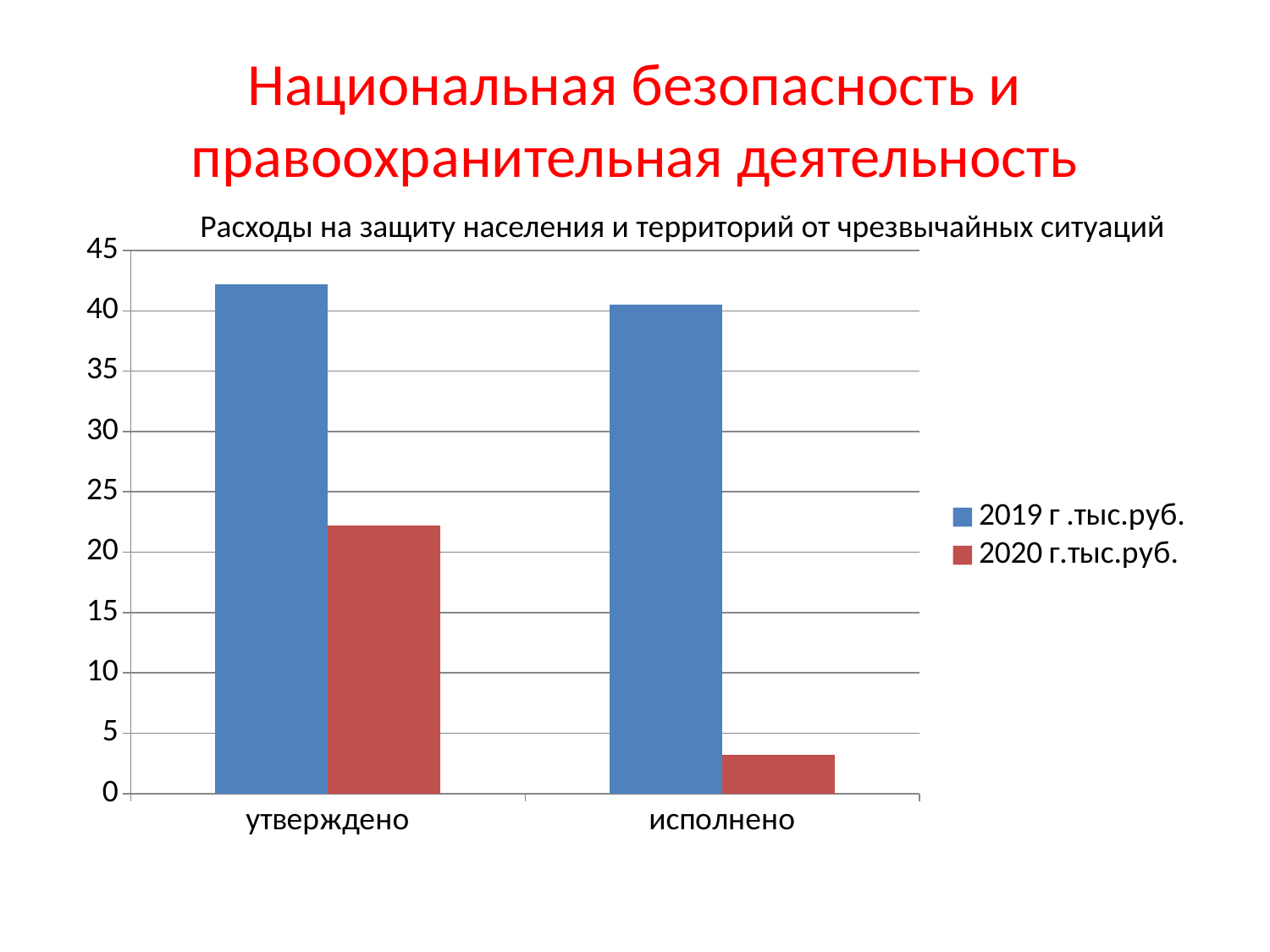
Is the value for 2019 г .тыс.руб. in the утверждено category greater or less than 40? greater Is the value for 2019 г .тыс.руб. in the исполнено category greater or less than 35? greater Is the value for 2020 г.тыс.руб. in the утверждено category greater or less than 25? less What kind of chart is shown on the slide? bar chart Which series is shown in red? 2020 г.тыс.руб. Which is larger in the исполнено category: 2019 г .тыс.руб. or 2020 г.тыс.руб.? 2019 г .тыс.руб. How many series does the legend list? 2 What is the title of the chart? Расходы на защиту населения и территорий от чрезвычайных ситуаций Which bar is the lowest in the chart? 2020 г.тыс.руб. in исполнено Which bar is the highest in the chart? 2019 г .тыс.руб. in утверждено How many categories are shown on the x axis? 2